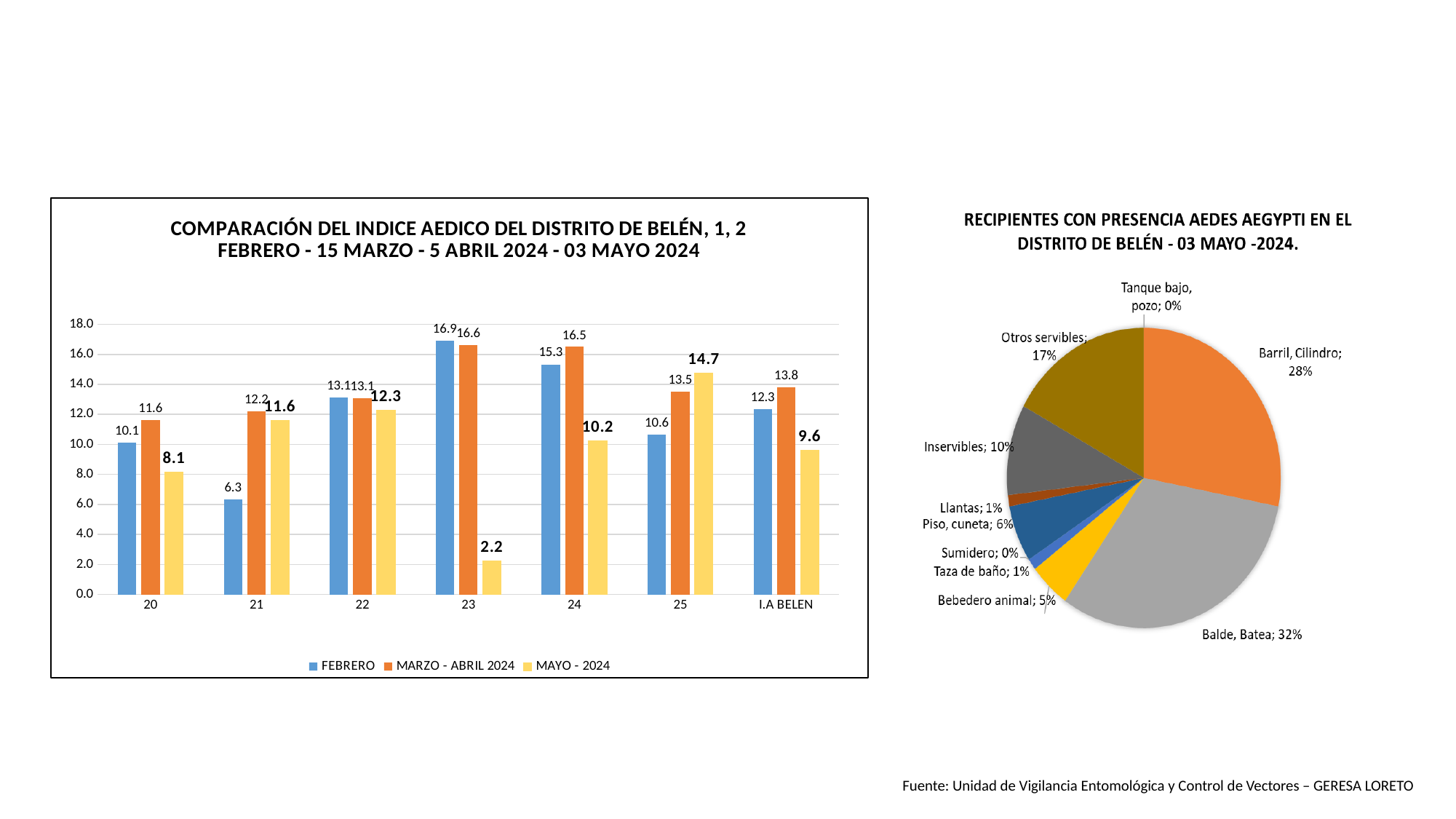
In the bar chart on the left, what is the MAYO - 2024 value for category 23? 2.2 What type of chart is shown on the right side of the slide? Pie chart In the bar chart on the left, what is the MARZO - ABRIL 2024 value for I.A BELEN? 13.8 How many categories are shown on the x axis of the bar chart on the left? 7 In the bar chart on the left, what is the FEBRERO value for category 21? 6.3 In the bar chart on the left, which category has the lowest MAYO - 2024 value? 23 In the bar chart on the left, what is the difference between the FEBRERO and MAYO - 2024 values for category 23? 14.7 How many series does the legend of the bar chart on the left list? 3 In the pie chart on the right, what share does Balde, Batea have? 32% In the bar chart on the left, which is larger for category 25: the FEBRERO value or the MAYO - 2024 value? MAYO - 2024 In the bar chart on the left, which category has the highest FEBRERO value? 23 In the pie chart on the right, which category has the largest share? Balde, Batea